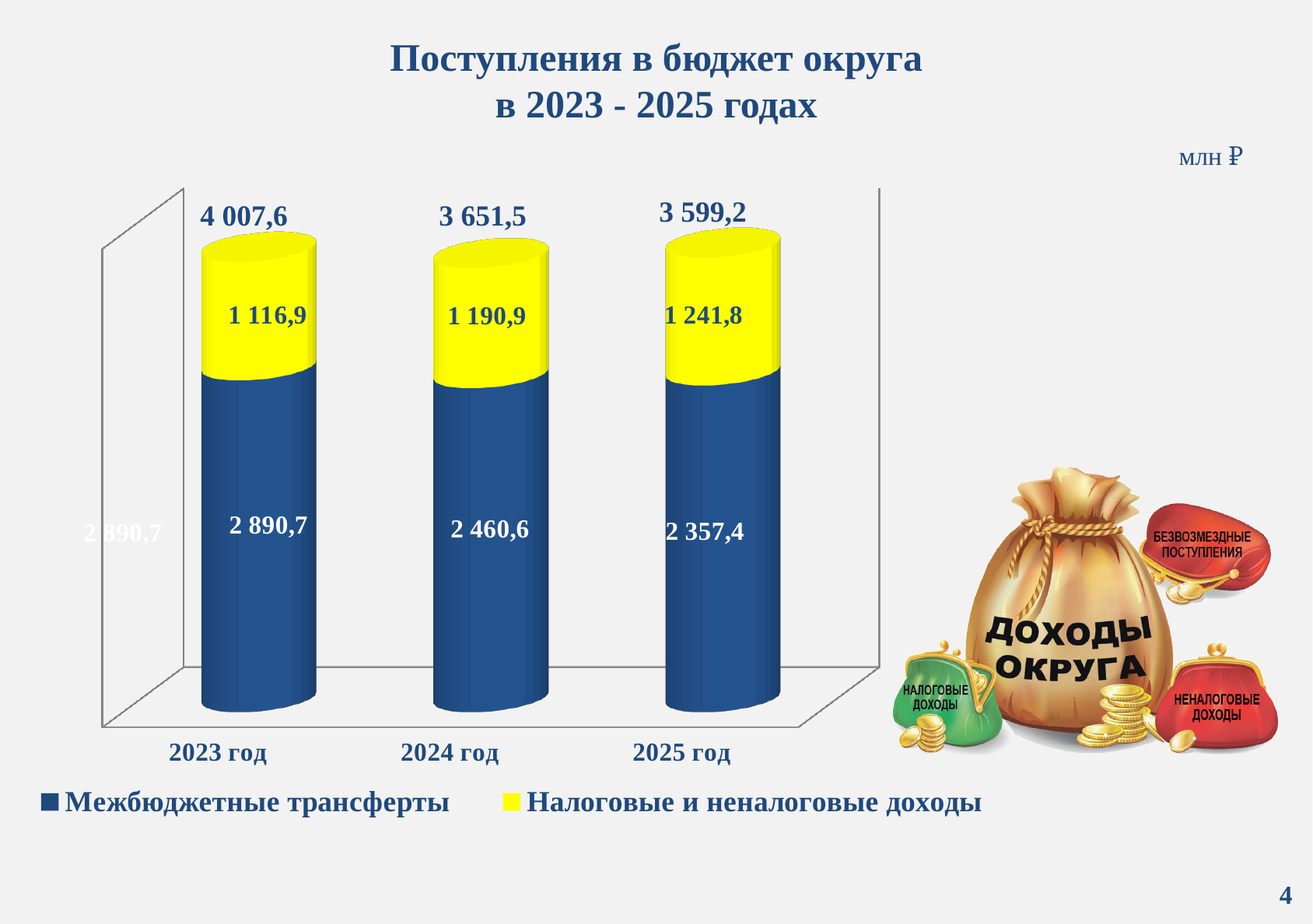
What is the total of the stacked bar for 2024 год? 3 651,5 What type of chart is shown on the slide? Stacked bar chart How does the value of Налоговые и неналоговые доходы change from 2023 год to 2025 год? It rises What is the value of Межбюджетные трансферты for 2024 год? 2 460,6 Which is larger: Налоговые и неналоговые доходы in 2024 год or in 2025 год? 2025 год What is the value of Налоговые и неналоговые доходы for 2025 год? 1 241,8 What is the difference between Межбюджетные трансферты in 2023 год and 2024 год? 430,1 Which year has the lowest value for Налоговые и неналоговые доходы? 2023 год Which year has the highest total budget receipts? 2023 год What is the value of Межбюджетные трансферты for 2023 год? 2 890,7 How many series does the legend list? 2 What is the difference between the total for 2023 год and the total for 2025 год? 408,4